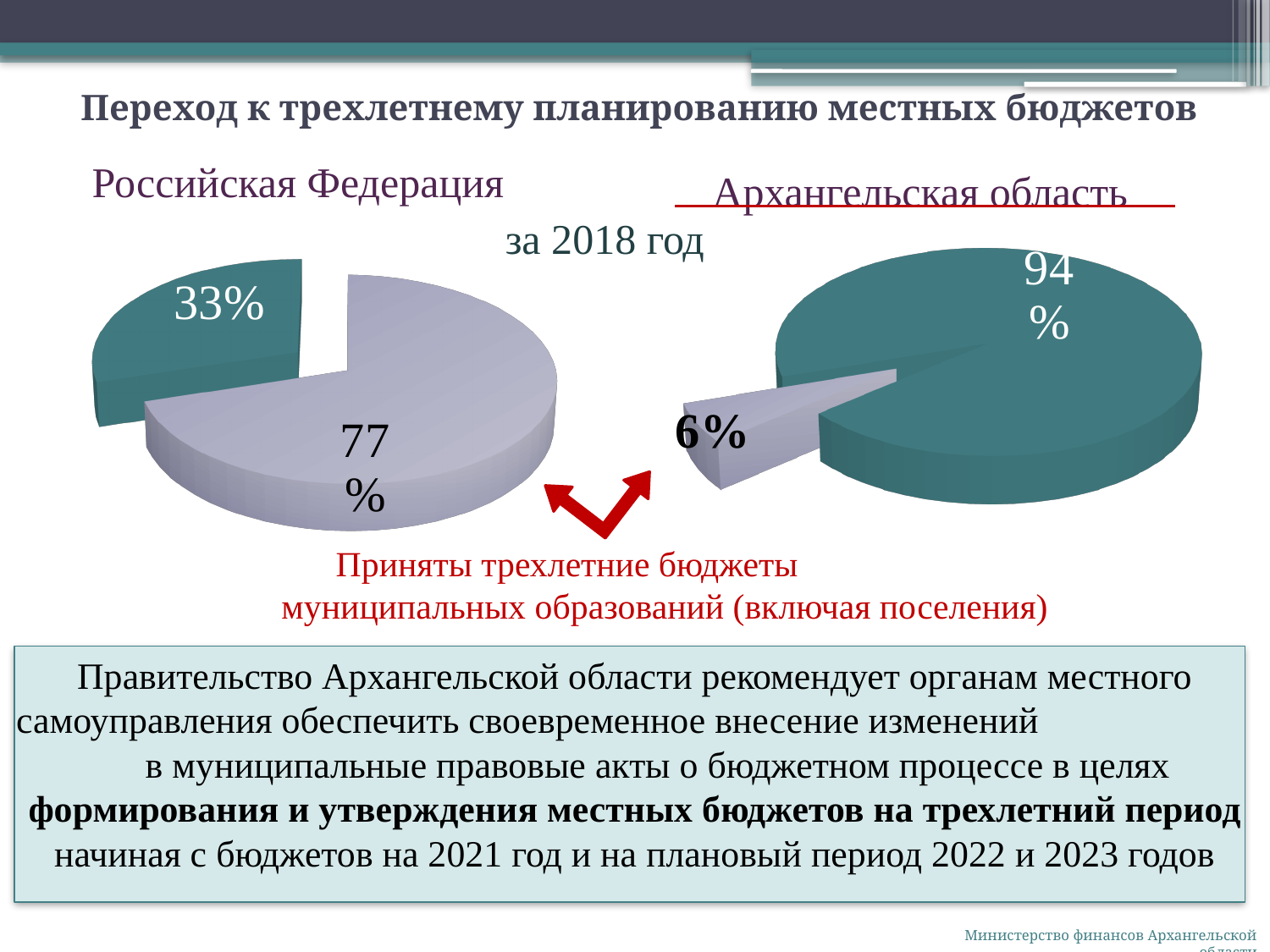
How many slices does the Архангельская область pie chart have? 2 Which is larger: the teal slice in the Российская Федерация chart or the teal slice in the Архангельская область chart? Архангельская область (94%) What year do the pie charts refer to, according to the text between them? 2018 In the Архангельская область pie chart, what value is shown on the teal slice? 94% What type of chart is used for the Российская Федерация data? pie chart How many slices does the Российская Федерация pie chart have? 2 In the Архангельская область pie chart, which slice is the largest? the teal slice (94%) In the Архангельская область pie chart, what value is shown on the grey slice? 6% In the Российская Федерация pie chart, which slice is the smallest? the teal slice (33%) In the Российская Федерация pie chart, what value is shown on the grey slice? 77% What is the difference between the two values in the Архангельская область pie chart? 88% In the Российская Федерация pie chart, what value is shown on the teal slice? 33%